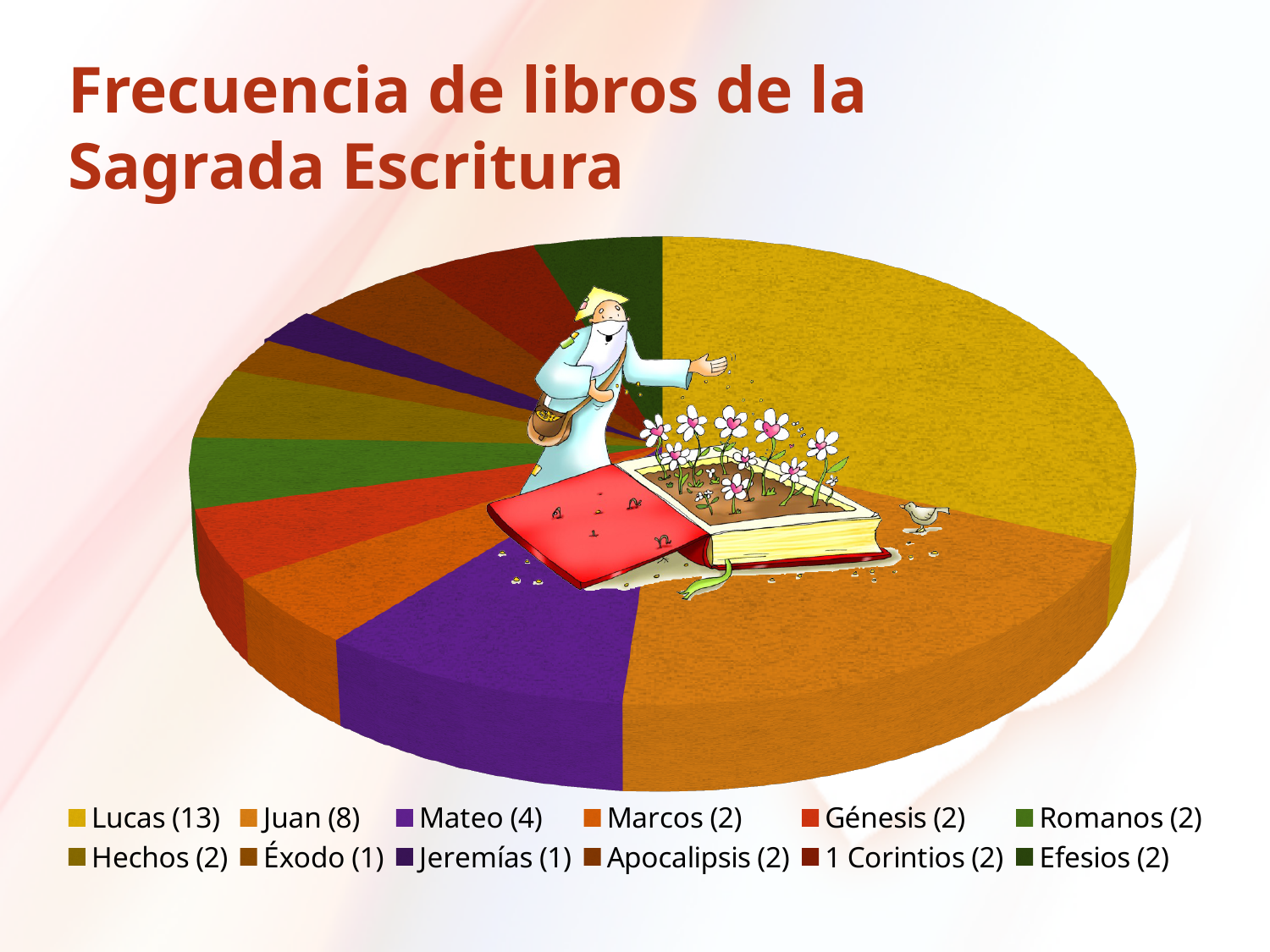
What is the frequency shown for Juan? 8 What is the total of all the frequencies shown in the legend? 41 What is the difference between the frequencies of Lucas and Juan? 5 What is the frequency shown for Éxodo? 1 Which has a higher frequency, Juan or Mateo? Juan What is the title of the chart? Frecuencia de libros de la Sagrada Escritura What is the frequency shown for Mateo? 4 Which book has the highest frequency in the chart? Lucas What kind of chart is shown on the slide? pie chart Which two books have the lowest frequency in the chart? Éxodo and Jeremías How many books (categories) does the pie chart show? 12 What is the frequency shown for Lucas? 13